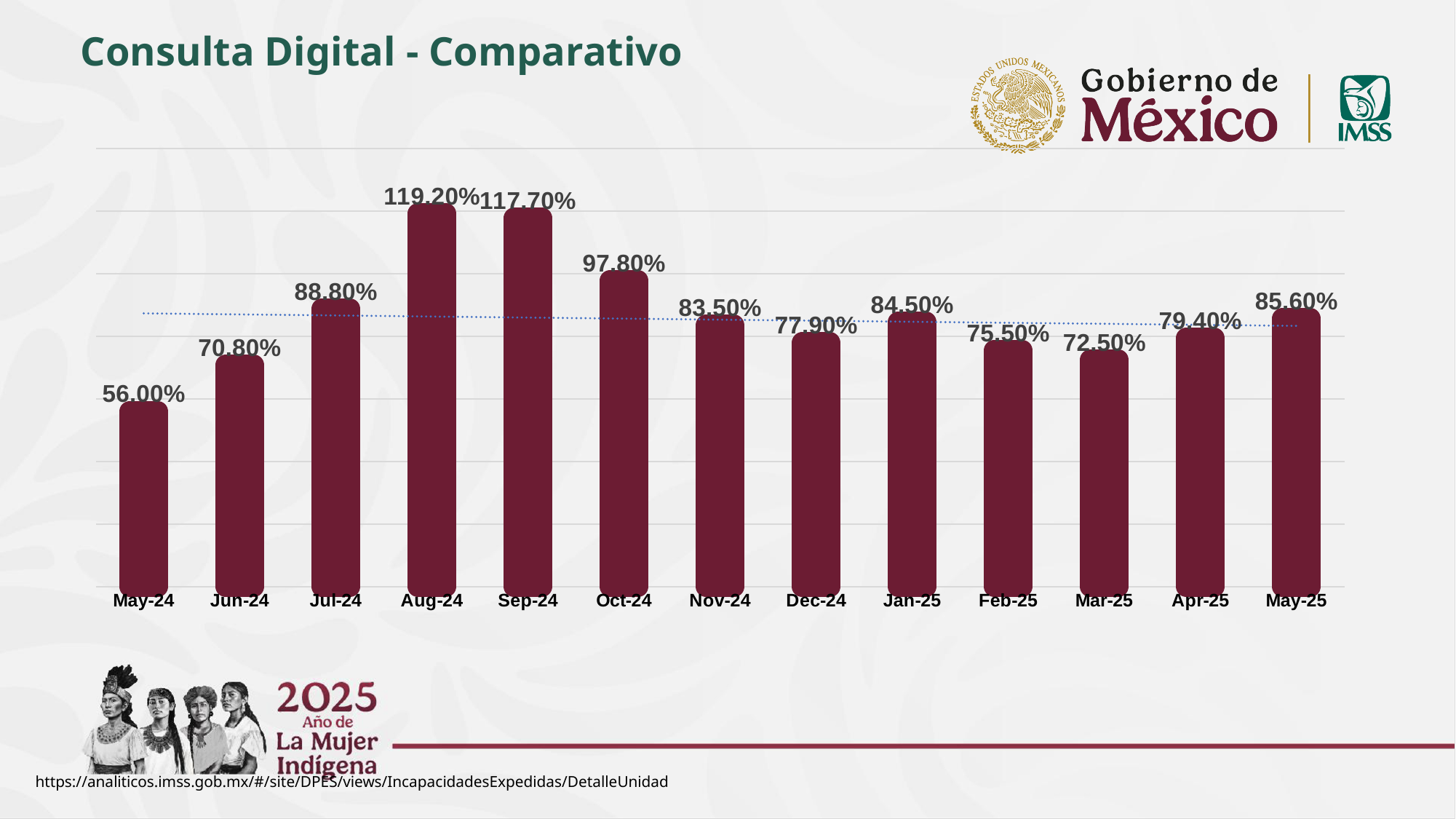
What is the difference between the values for Aug-24 and Sep-24? 1.50 percentage points What kind of chart is shown on the slide? Bar chart What is the value for Mar-25? 72.50% What is the difference between the values for May-25 and May-24? 29.60 percentage points Do the values rise or fall from May-24 to Aug-24? Rise Which month has the lowest value? May-24 Which month has the highest value? Aug-24 Which is larger, the value for Oct-24 or the value for Nov-24? Oct-24 What is the value for May-24? 56.00% What is the value for Jan-25? 84.50% What is the value for Aug-24? 119.20% How many months are shown on the x axis? 13